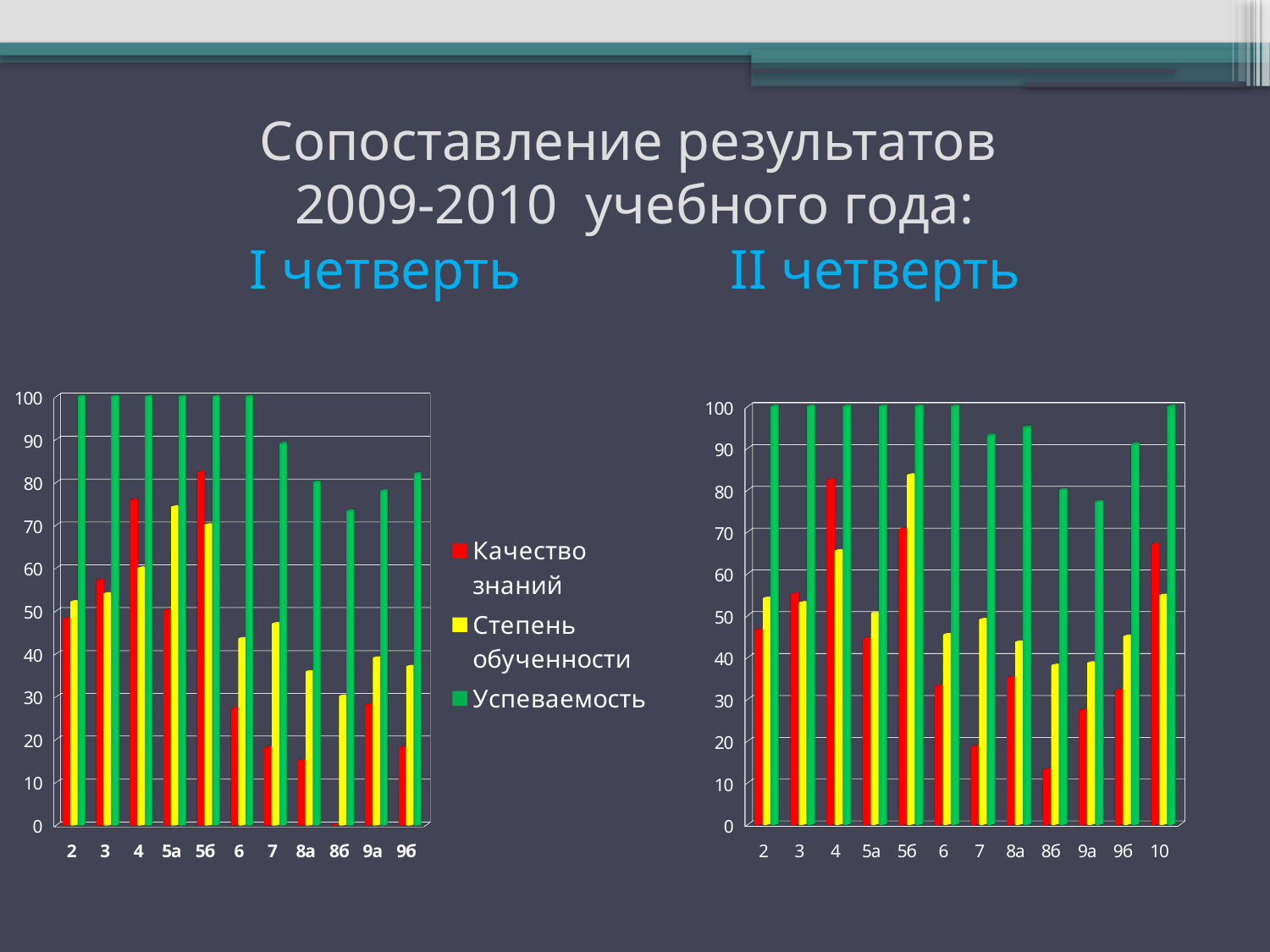
In the I четверть chart on the left, what is the Успеваемость value for category 2? 100 In the II четверть chart on the right, is the Степень обученности value for 5б greater or less than 80? greater In the I четверть chart on the left, which category has the highest Качество знаний value? 5б How many categories are shown on the x axis of the I четверть chart on the left? 11 Which legend entry is shown in green? Успеваемость In the II четверть chart on the right, what is the Успеваемость value for category 10? 100 How many categories are shown on the x axis of the II четверть chart on the right? 12 In the I четверть chart on the left, is the Качество знаний value for 8а greater or less than 20? less How many series does the legend list? 3 In the I четверть chart on the left, which is larger: the Качество знаний value for 3 or for 4? 4 In the II четверть chart on the right, which category has the highest Качество знаний value? 4 What kind of chart is the I четверть chart on the left? bar chart